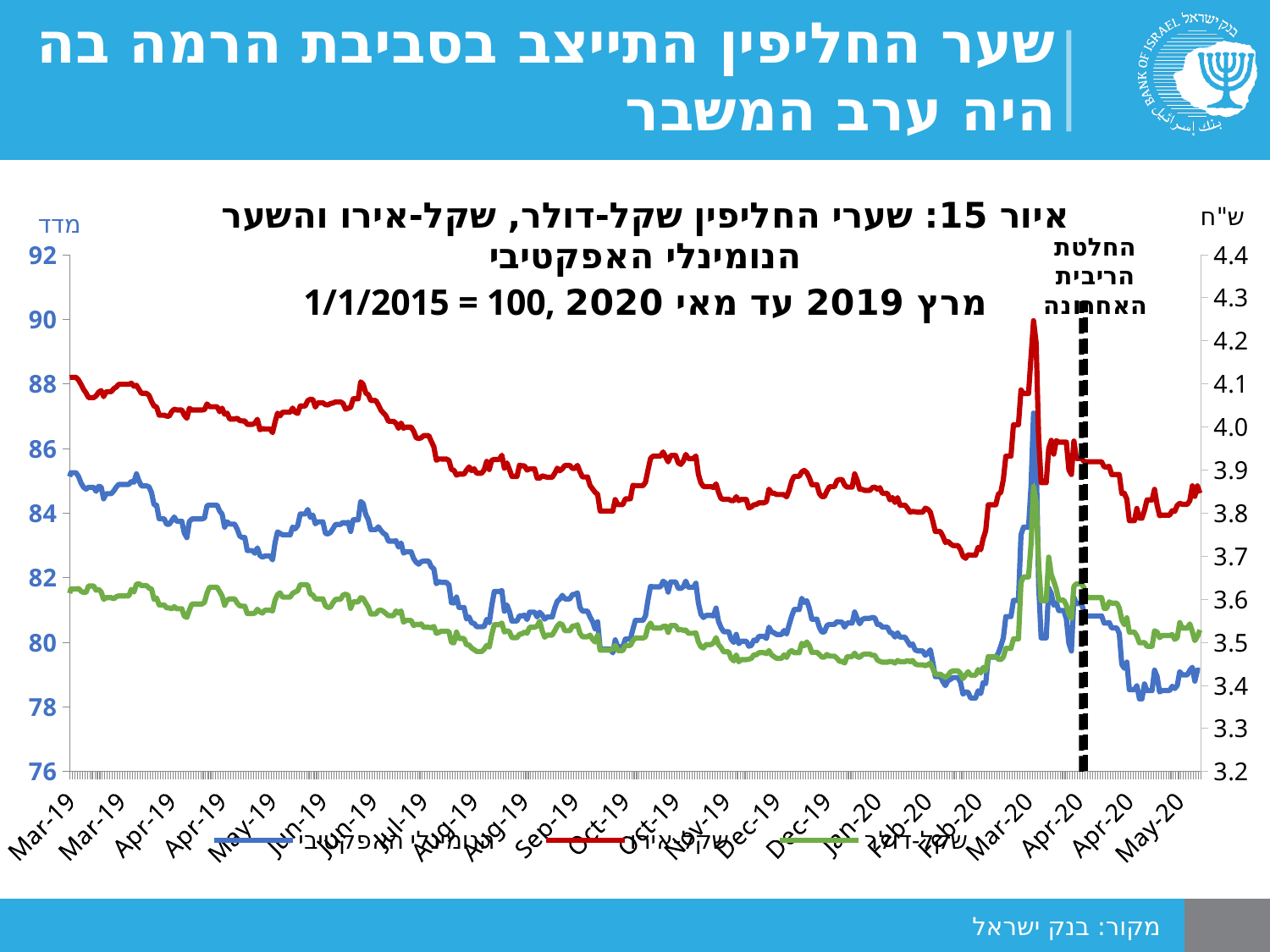
How many series does the chart's legend list? 3 What does the dashed vertical line near Apr-20 mark, according to its label? החלטת הריבית האחרונה What is the title of the chart? איור 15: שערי החליפין שקל-דולר, שקל-אירו והשער הנומינלי האפקטיבי 1/1/2015 = 100, מרץ 2019 עד מאי 2020 Does the שער נומינלי אפקטיבי series overall rise or fall from Mar-19 to May-20? fall Is the value of the שקל-דולר series at Mar-19 greater or less than 3.5 on the right axis? greater Is the value of the שער נומינלי אפקטיבי series at May-20 greater or less than 80 on the left axis? less Is the peak of the שקל-אירו series in Mar-20 greater or less than 4.1 on the right axis? greater What kind of chart is shown on the slide? line chart Which series, שקל-אירו or שקל-דולר, has the higher values throughout the chart? שקל-אירו In which month does the שקל-אירו series reach its highest point? Mar-20